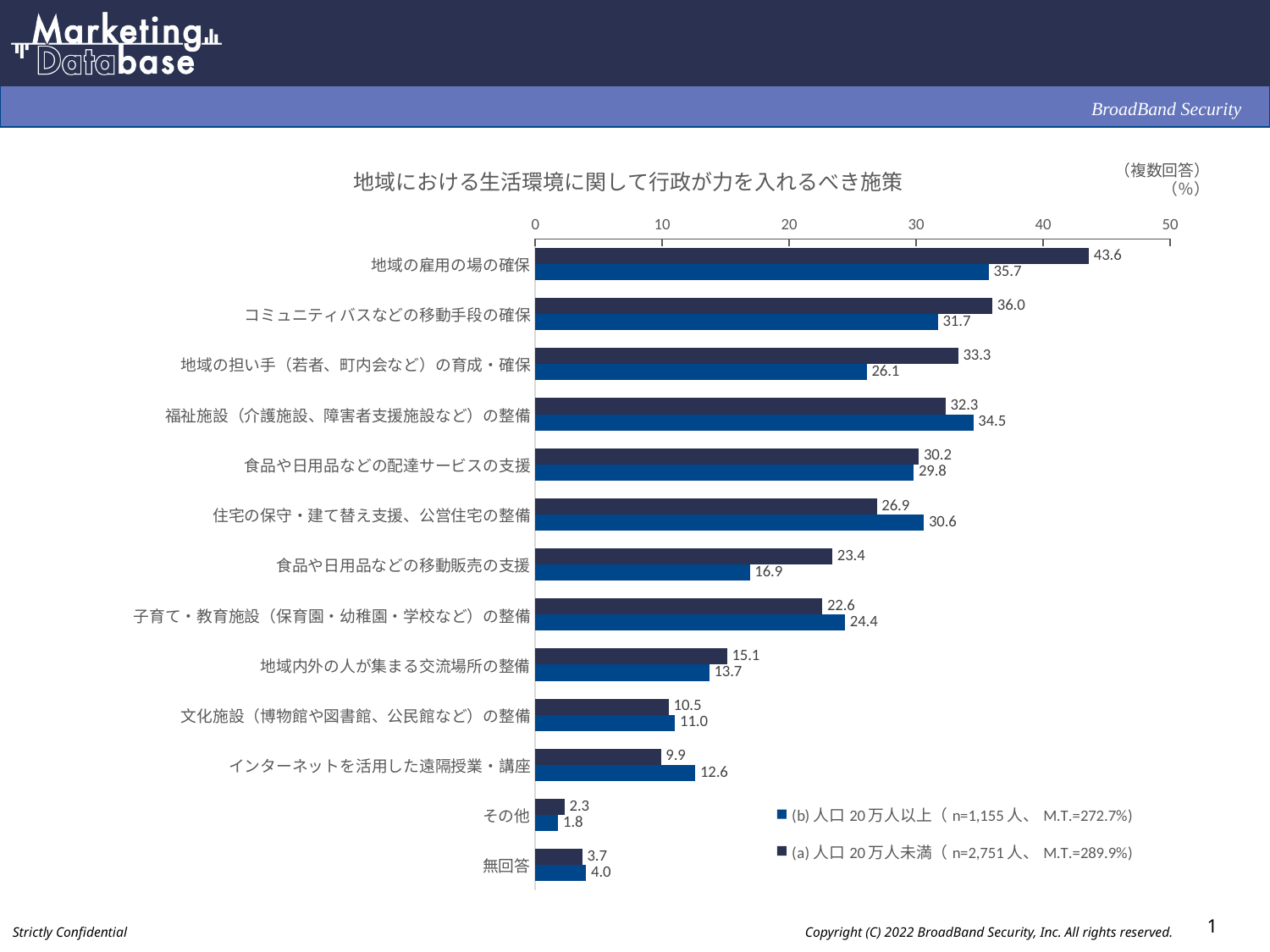
Is the value of the upper bar for コミュニティバスなどの移動手段の確保 greater or less than 30? greater What is the difference between the upper and lower bars for 地域の雇用の場の確保? 7.9 What is the value of the lower bar for インターネットを活用した遠隔授業・講座? 12.6 What is the value of the lower bar for 福祉施設（介護施設、障害者支援施設など）の整備? 34.5 Which category has the highest value in the chart? 地域の雇用の場の確保 How many series does the legend list? 2 According to the legend, what is the sample size (n) for (b) 人口20万人以上? 1,155人 How many categories are plotted on the vertical axis? 13 For 住宅の保守・建て替え支援、公営住宅の整備, which bar is larger, the upper or the lower? lower What kind of chart is shown on the slide? bar chart Which category has the lowest value in the chart? その他 What is the value of the upper bar for 地域の雇用の場の確保? 43.6